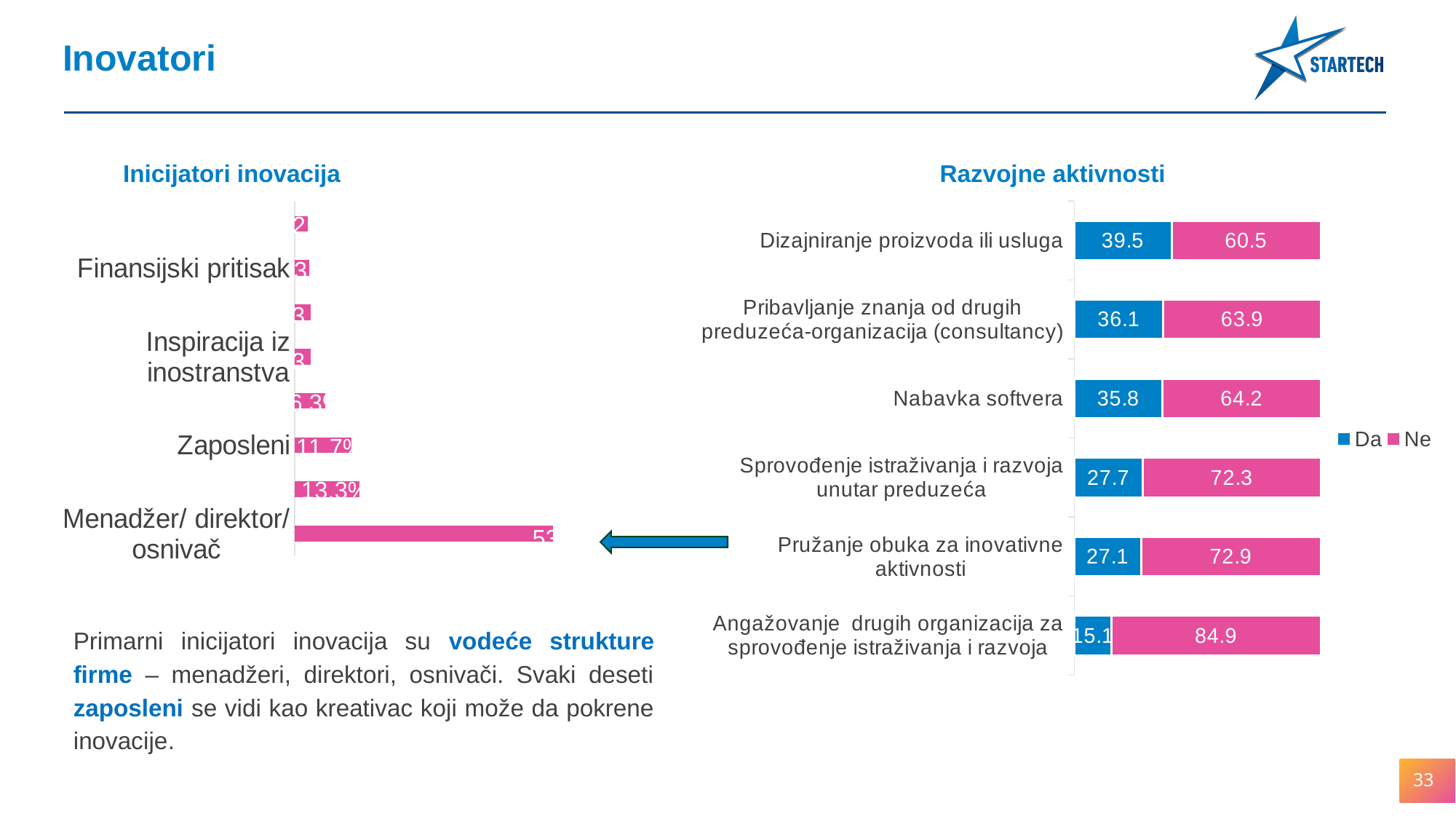
In the 'Razvojne aktivnosti' chart, what is the 'Da' value for Pružanje obuka za inovativne aktivnosti? 27.1 In the 'Razvojne aktivnosti' chart, what is the total of the stacked bar for Nabavka softvera? 100 What kind of chart is the 'Razvojne aktivnosti' chart? Stacked bar chart In the 'Inicijatori inovacija' chart, which category has the longest bar? Menadžer/ direktor/ osnivač In the 'Razvojne aktivnosti' chart, which activity has the highest 'Da' value? Dizajniranje proizvoda ili usluga In the 'Razvojne aktivnosti' chart, what is the difference between the 'Ne' value for Angažovanje drugih organizacija za sprovođenje istraživanja i razvoja and the 'Ne' value for Dizajniranje proizvoda ili usluga? 24.4 How many series does the legend of the 'Razvojne aktivnosti' chart list? 2 In the 'Razvojne aktivnosti' chart, what is the 'Da' value for Nabavka softvera? 35.8 In the 'Razvojne aktivnosti' chart, which is larger: the 'Da' value for Pribavljanje znanja od drugih preduzeća-organizacija (consultancy) or the 'Da' value for Sprovođenje istraživanja i razvoja unutar preduzeća? Pribavljanje znanja od drugih preduzeća-organizacija (consultancy) How many activities are shown in the 'Razvojne aktivnosti' chart? 6 In the 'Razvojne aktivnosti' chart, what is the 'Ne' value for Dizajniranje proizvoda ili usluga? 60.5 In the 'Razvojne aktivnosti' chart, which activity has the lowest 'Da' value? Angažovanje drugih organizacija za sprovođenje istraživanja i razvoja